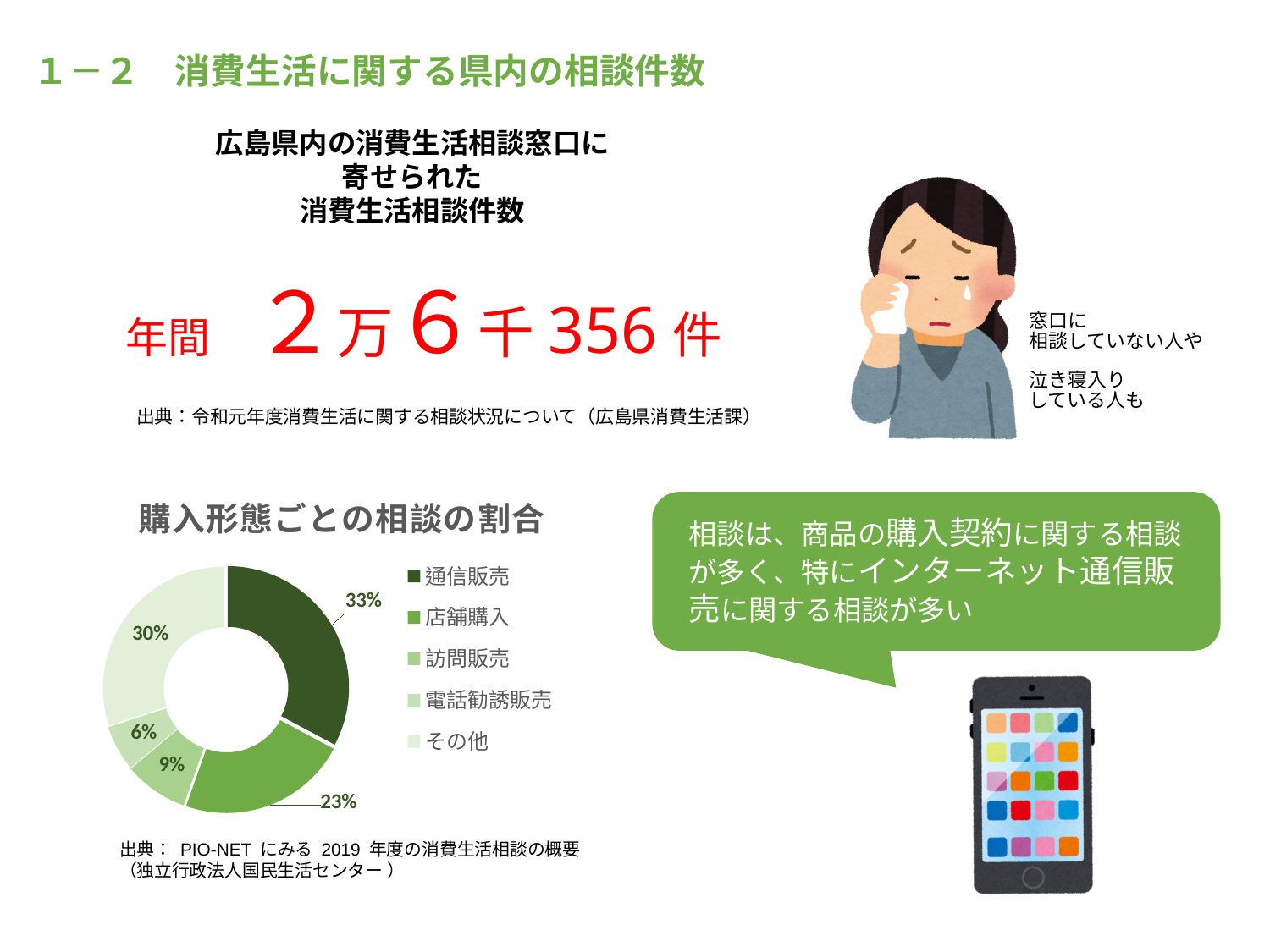
「購入形態ごとの相談の割合」のグラフはどの種類のグラフですか？ ドーナツグラフ（円グラフ） 「購入形態ごとの相談の割合」のグラフの凡例で、最初に挙げられている項目は何ですか？ 通信販売 「購入形態ごとの相談の割合」のグラフで、通信販売の割合は何%ですか？ 33% 「購入形態ごとの相談の割合」のグラフで、最も割合が小さい購入形態はどれですか？ 電話勧誘販売 「購入形態ごとの相談の割合」のグラフで、訪問販売の割合は何%ですか？ 9% 「購入形態ごとの相談の割合」のグラフには、いくつの購入形態が示されていますか？ 5 「購入形態ごとの相談の割合」のグラフで、電話勧誘販売の割合は何%ですか？ 6% 「購入形態ごとの相談の割合」のグラフで、最も割合が大きい購入形態はどれですか？ 通信販売 「購入形態ごとの相談の割合」のグラフで、店舗購入の割合は何%ですか？ 23% 「購入形態ごとの相談の割合」のグラフで、通信販売と店舗購入の割合の差は何ポイントですか？ 10ポイント 「購入形態ごとの相談の割合」のグラフで、その他の割合は何%ですか？ 30% 「購入形態ごとの相談の割合」のグラフで、訪問販売と電話勧誘販売ではどちらの割合が大きいですか？ 訪問販売